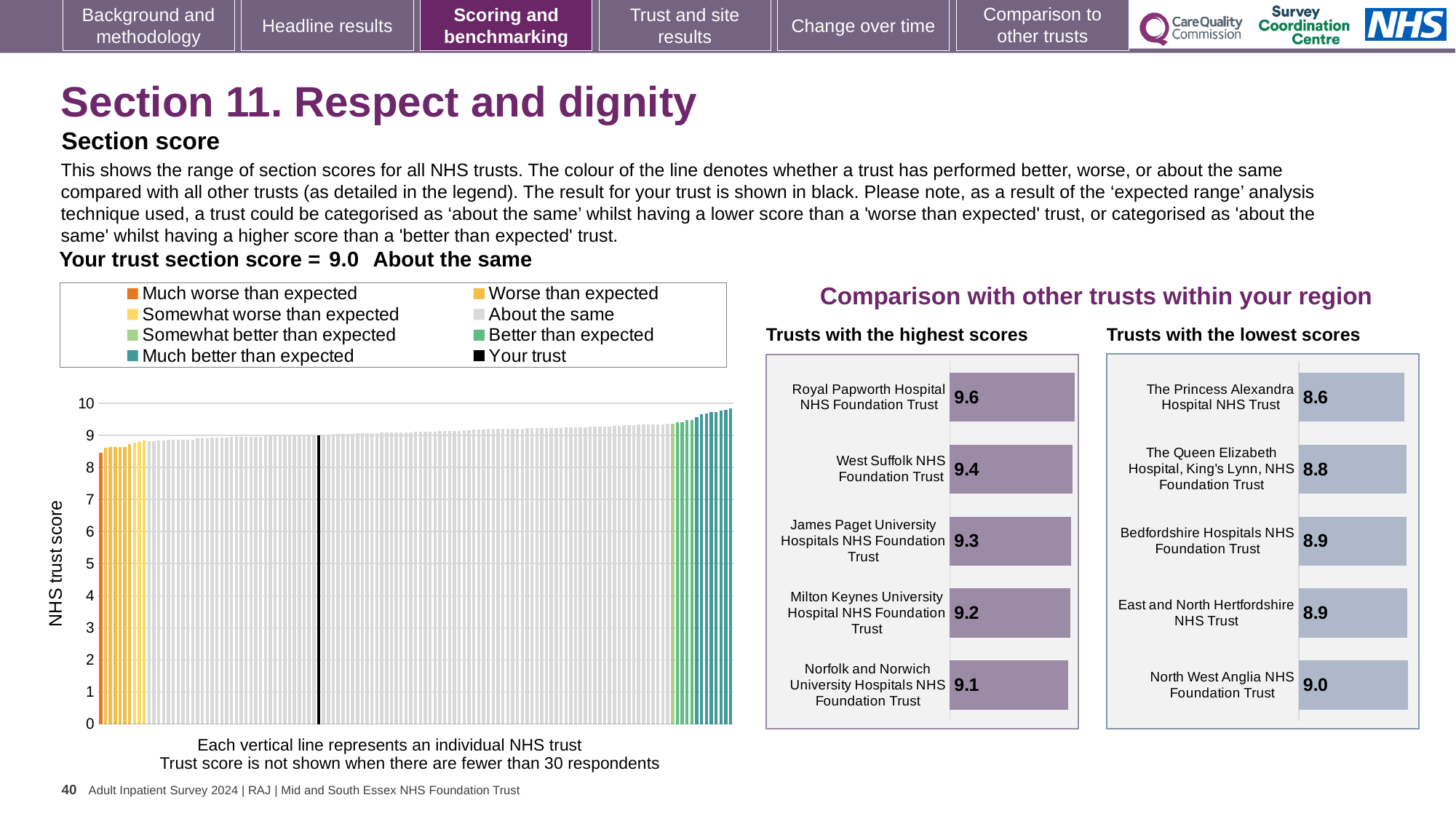
In the 'Trusts with the lowest scores' chart, what is the difference between the scores of North West Anglia NHS Foundation Trust and The Princess Alexandra Hospital NHS Trust? 0.4 In the 'Trusts with the highest scores' chart, what is the score for Royal Papworth Hospital NHS Foundation Trust? 9.6 In the 'Trusts with the lowest scores' chart, which trust has the lowest score? The Princess Alexandra Hospital NHS Trust In the 'Trusts with the lowest scores' chart, what is the score for The Princess Alexandra Hospital NHS Trust? 8.6 In the 'Trusts with the highest scores' chart, what is the score for Norfolk and Norwich University Hospitals NHS Foundation Trust? 9.1 In the 'Trusts with the highest scores' chart, what is the difference between the scores of Royal Papworth Hospital NHS Foundation Trust and West Suffolk NHS Foundation Trust? 0.2 In the 'Trusts with the lowest scores' chart, which has the larger score: The Queen Elizabeth Hospital, King's Lynn, NHS Foundation Trust or North West Anglia NHS Foundation Trust? North West Anglia NHS Foundation Trust What kind of chart is the NHS trust score chart on the left of the slide? Bar chart How many trusts are listed in the 'Trusts with the lowest scores' chart? 5 How many entries does the legend of the NHS trust score chart on the left list? 8 In the NHS trust score chart on the left, do the bar values rise or fall from left to right? Rise In the 'Trusts with the highest scores' chart, which trust has the highest score? Royal Papworth Hospital NHS Foundation Trust